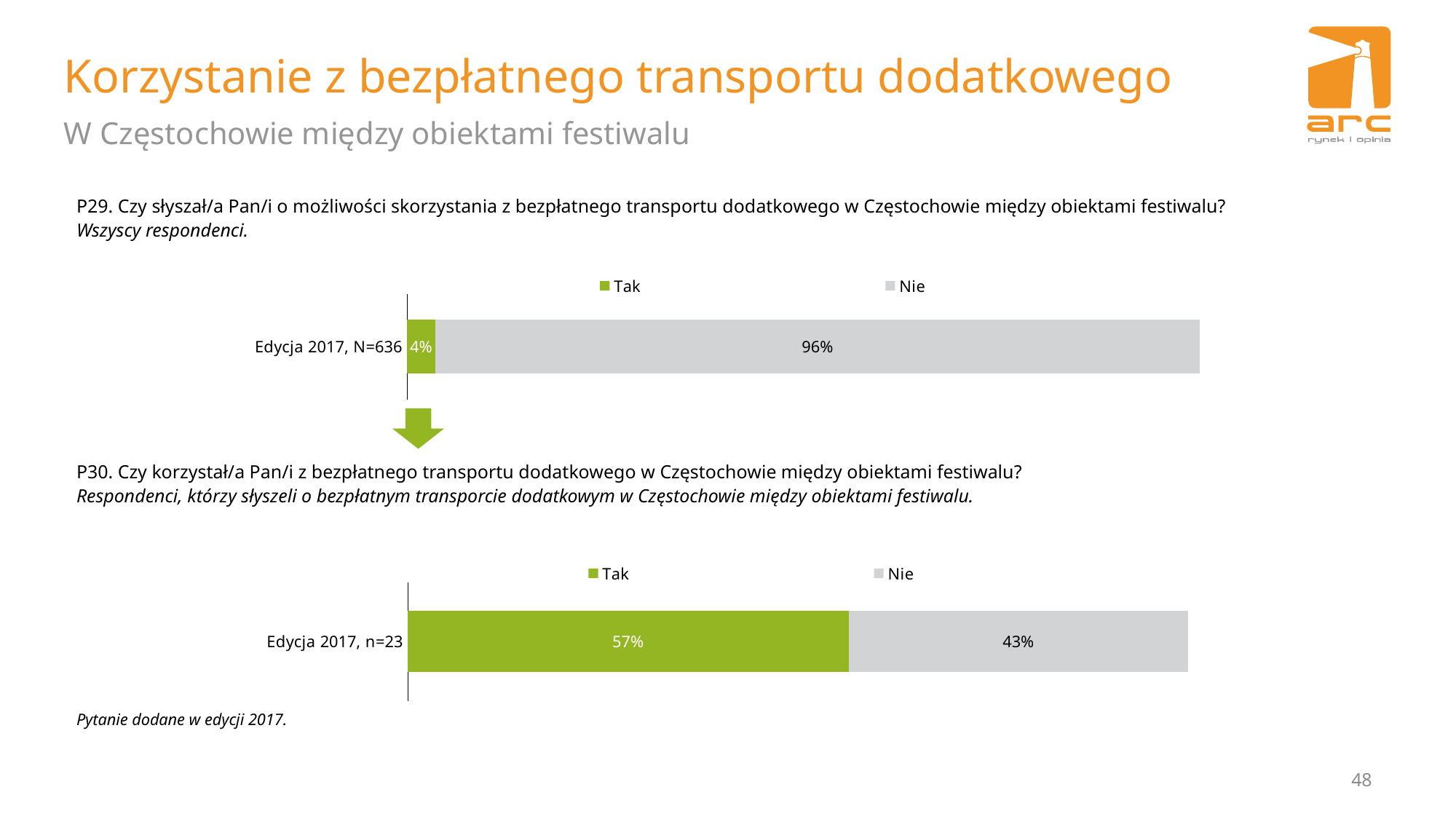
In the bottom chart (P30), what percentage of respondents answered "Nie"? 43% In the top chart (P29), what percentage of respondents answered "Nie"? 96% What kind of chart is the bottom chart (P30)? Stacked bar chart In the top chart (P29), which answer has the larger share, "Tak" or "Nie"? Nie In the top chart (P29), what is the difference between the "Nie" and "Tak" shares? 92 percentage points How many series does the legend of the top chart (P29) list? 2 In the bottom chart (P30), which answer has the larger share, "Tak" or "Nie"? Tak In the bottom chart (P30), what is the total of the stacked bar for "Edycja 2017, n=23"? 100% In the bottom chart (P30), what is the difference between the "Tak" and "Nie" shares? 14 percentage points In the bottom chart (P30), what percentage of respondents answered "Tak"? 57% In the top chart (P29), what percentage of respondents answered "Tak"? 4% What is the category label of the bar in the top chart (P29)? Edycja 2017, N=636